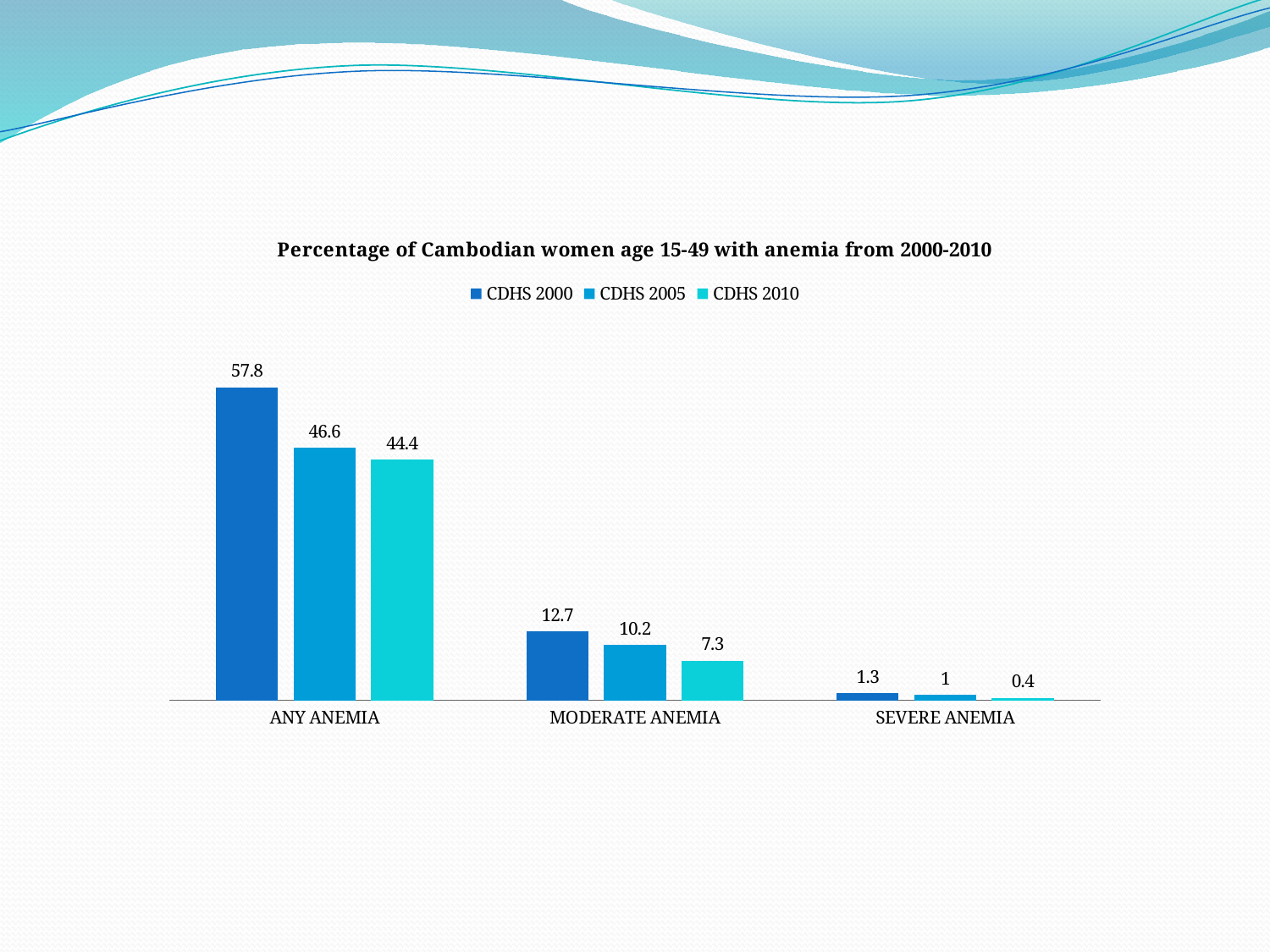
What is the value for CDHS 2000 in the Any Anemia category? 57.8 What is the value for CDHS 2010 in the Moderate Anemia category? 7.3 How many categories are shown on the x axis? 3 What kind of chart is shown on the slide? Bar chart Which is larger: the CDHS 2005 value for Any Anemia or the CDHS 2010 value for Any Anemia? CDHS 2005 How many series does the legend list? 3 Which category has the highest value for CDHS 2005? Any Anemia What is the difference between the CDHS 2000 and CDHS 2005 values for Moderate Anemia? 2.5 What is the title of the chart? Percentage of Cambodian women age 15-49 with anemia from 2000-2010 What is the difference between the CDHS 2000 and CDHS 2010 values for Any Anemia? 13.4 Which category has the lowest value for CDHS 2010? Severe Anemia What is the value for CDHS 2005 in the Severe Anemia category? 1